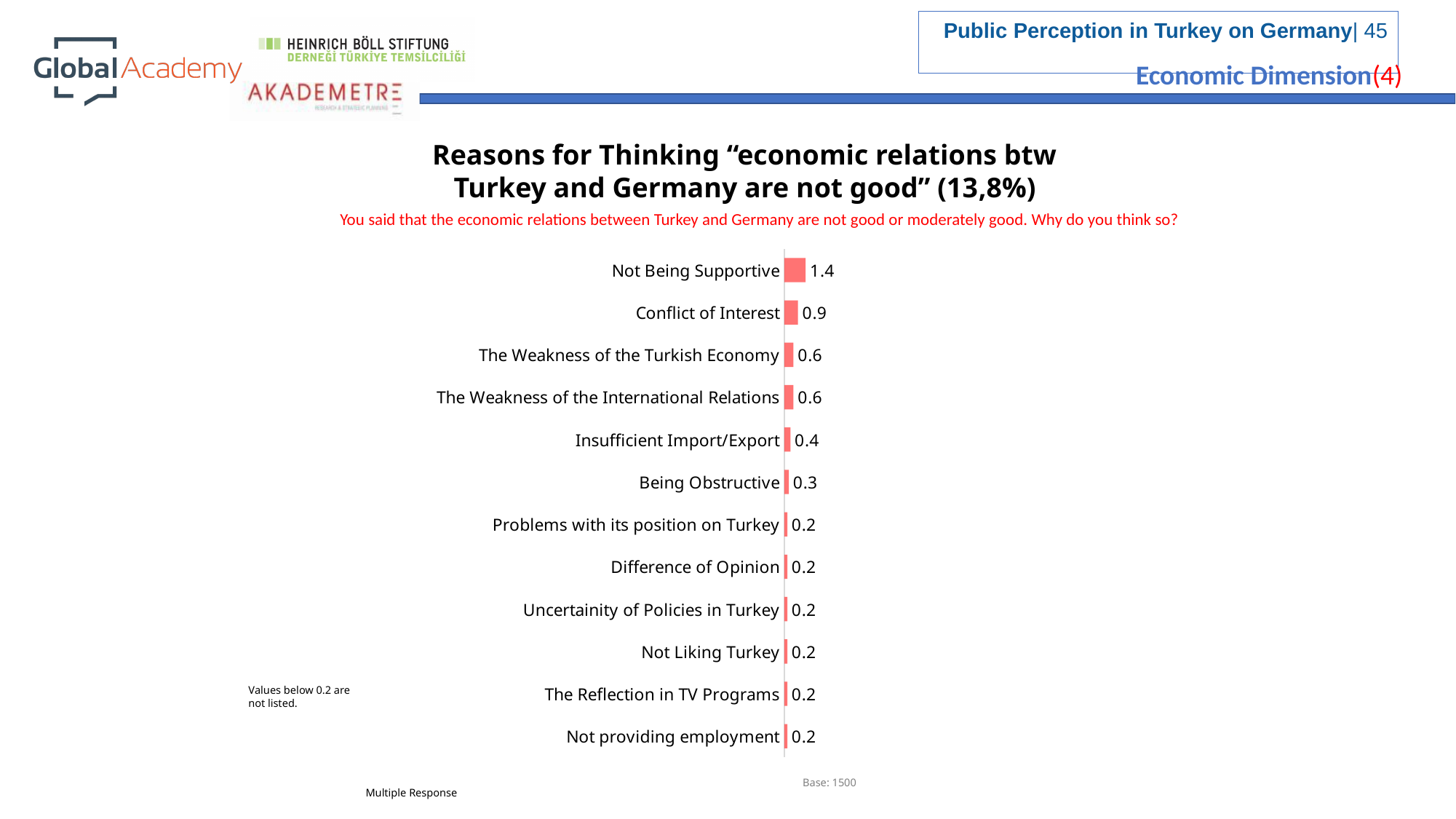
How many categories are shown in the chart? 12 How many categories have a value of 0.2? 6 What is the difference between the values for Not Being Supportive and Conflict of Interest? 0.5 What is the value for Conflict of Interest? 0.9 What is the base (number of respondents) noted below the chart? 1500 What is the value for Being Obstructive? 0.3 What is the difference between the values for Conflict of Interest and The Weakness of the Turkish Economy? 0.3 Which category has the highest value? Not Being Supportive Which is larger, the value for Insufficient Import/Export or the value for Being Obstructive? Insufficient Import/Export What is the value for Insufficient Import/Export? 0.4 What kind of chart is shown on the slide? Bar chart What is the value for Not Being Supportive? 1.4